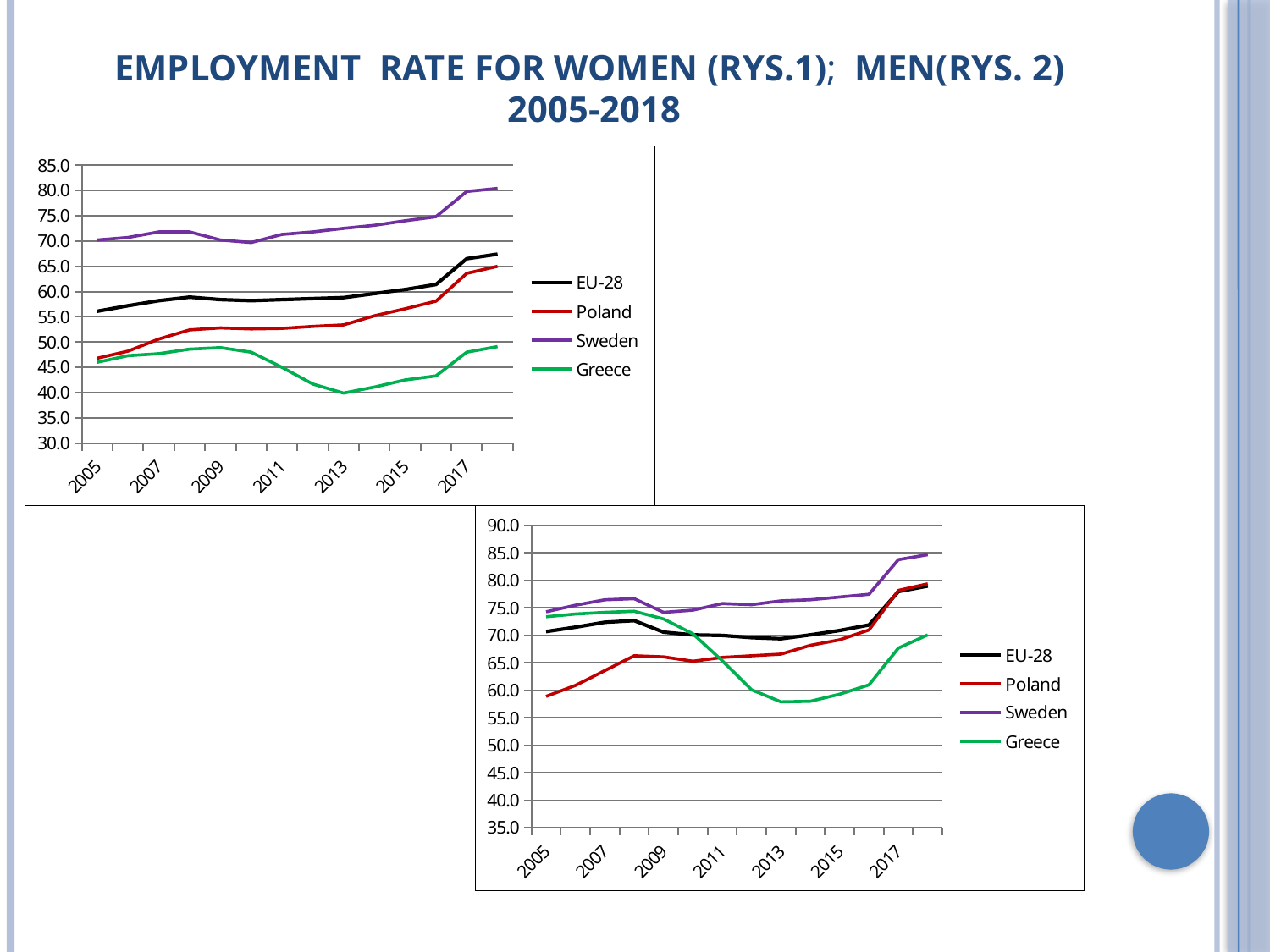
In the top-left chart (women), is the value for Greece in 2013 greater or less than 45.0? less In the bottom-right chart (men), which is larger in 2009: the value for Poland or the value for Greece? Greece In the top-left chart (women), is the value for Sweden in 2017 greater or less than 75.0? greater In the bottom-right chart (men), what colour is the line for Sweden? purple How many series does the legend of the bottom-right chart (employment rate for men) list? 4 What kind of chart is the top-left chart (employment rate for women)? line chart In the bottom-right chart (men), is the value for Sweden in 2018 greater or less than 80.0? greater In the top-left chart (women), which series has the highest values throughout the period? Sweden In the top-left chart (women), which series has the lowest values throughout the period? Greece In the top-left chart (women), does the Sweden series generally rise or fall from 2005 to 2018? rise In the top-left chart (women), which is larger in 2013: the value for Poland or the value for Greece? Poland